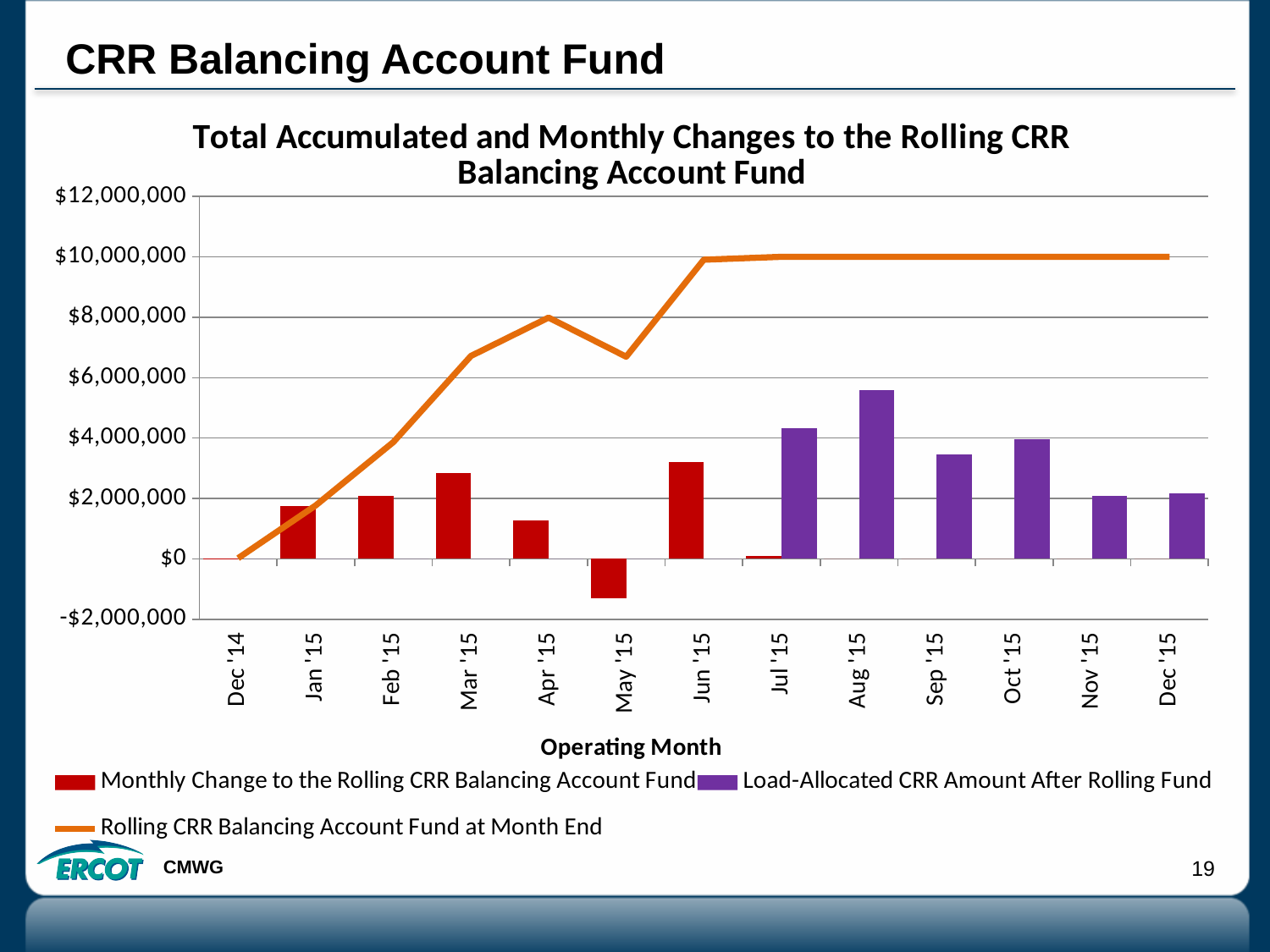
Is the Rolling CRR Balancing Account Fund at Month End for Jun '15 greater or less than $8,000,000? greater Is the Monthly Change to the Rolling CRR Balancing Account Fund for May '15 greater or less than $0? less Is the Load-Allocated CRR Amount After Rolling Fund for Aug '15 greater or less than $4,000,000? greater Which month has the highest Monthly Change to the Rolling CRR Balancing Account Fund? Jun '15 What is the title of the x axis? Operating Month How many operating months are shown on the x axis? 13 Does the Rolling CRR Balancing Account Fund at Month End rise or fall from Dec '14 to Apr '15? Rise Which month has the highest Load-Allocated CRR Amount After Rolling Fund? Aug '15 Which month has the larger Monthly Change to the Rolling CRR Balancing Account Fund, Mar '15 or Apr '15? Mar '15 Which month has the lowest Monthly Change to the Rolling CRR Balancing Account Fund? May '15 How many series does the legend list? 3 What kind of chart is shown on the slide? A combined bar and line chart